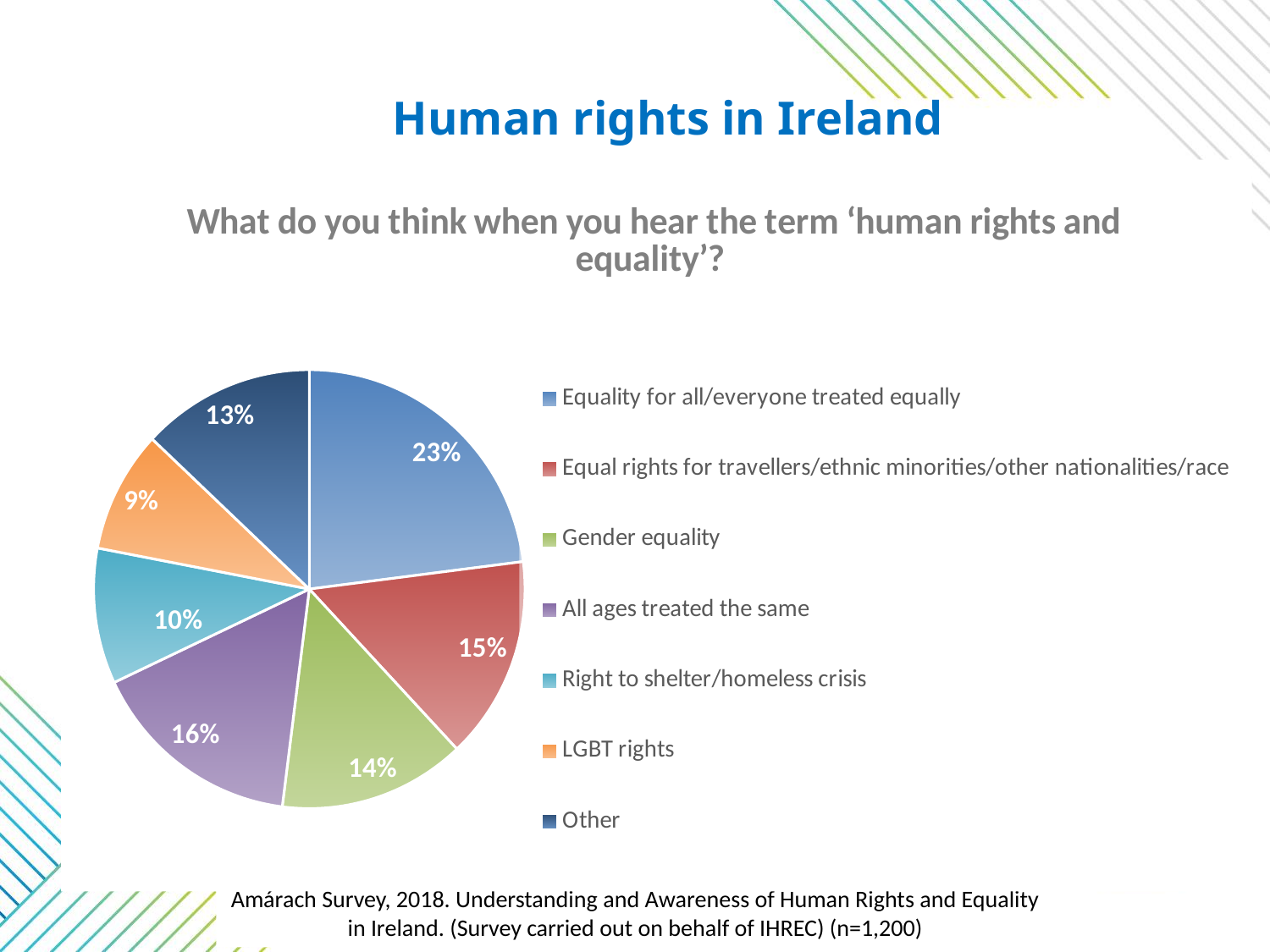
What percentage is shown for 'Other'? 13% What percentage of the pie is 'Equality for all/everyone treated equally'? 23% What percentage is shown for 'Gender equality'? 14% What is the difference in percentage points between 'All ages treated the same' and 'Equal rights for travellers/ethnic minorities/other nationalities/race'? 1 How many categories does the pie chart have? 7 What percentage is shown for 'Right to shelter/homeless crisis'? 10% Which is larger: the share for 'Gender equality' or the share for 'Other'? Gender equality Which category has the smallest share of the pie? LGBT rights Which category has the largest share of the pie? Equality for all/everyone treated equally What colour is the slice for 'Equal rights for travellers/ethnic minorities/other nationalities/race'? Red What kind of chart is shown on the slide? Pie chart What percentage is shown for 'LGBT rights'? 9%